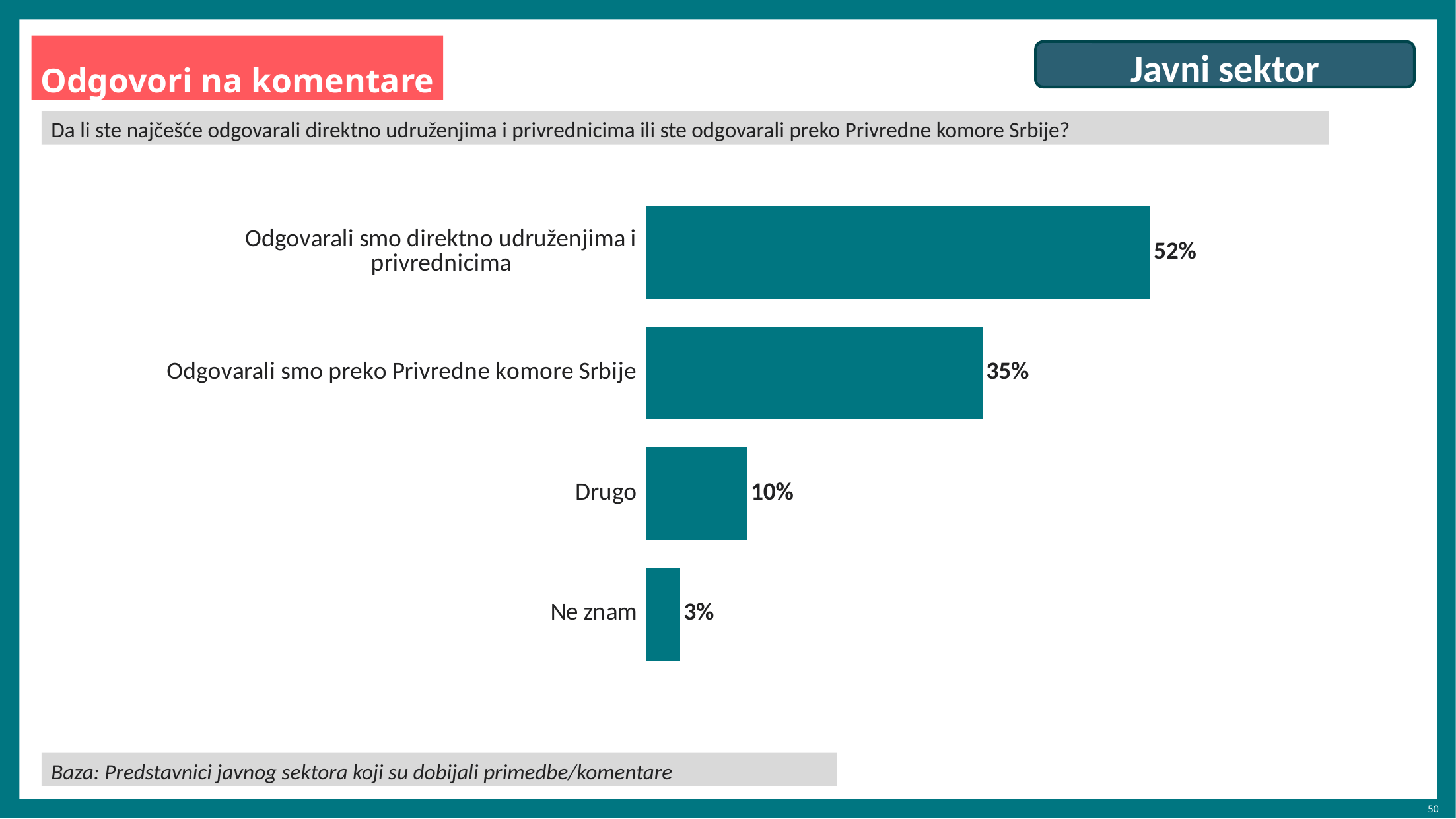
What is the value for "Drugo"? 10% What is the value for "Odgovarali smo direktno udruženjima i privrednicima"? 52% Which category has the highest value? Odgovarali smo direktno udruženjima i privrednicima How many categories are shown in the chart? 4 Which is larger, the value for "Odgovarali smo preko Privredne komore Srbije" or the value for "Drugo"? Odgovarali smo preko Privredne komore Srbije What is the value for "Odgovarali smo preko Privredne komore Srbije"? 35% Which category has the lowest value? Ne znam What is the difference between the values for "Drugo" and "Ne znam"? 7% What is the value for "Ne znam"? 3% What is the difference between the values for "Odgovarali smo direktno udruženjima i privrednicima" and "Odgovarali smo preko Privredne komore Srbije"? 17% What question is the chart answering, as shown in the grey box above it? Da li ste najčešće odgovarali direktno udruženjima i privrednicima ili ste odgovarali preko Privredne komore Srbije? What kind of chart is shown on the slide? Bar chart